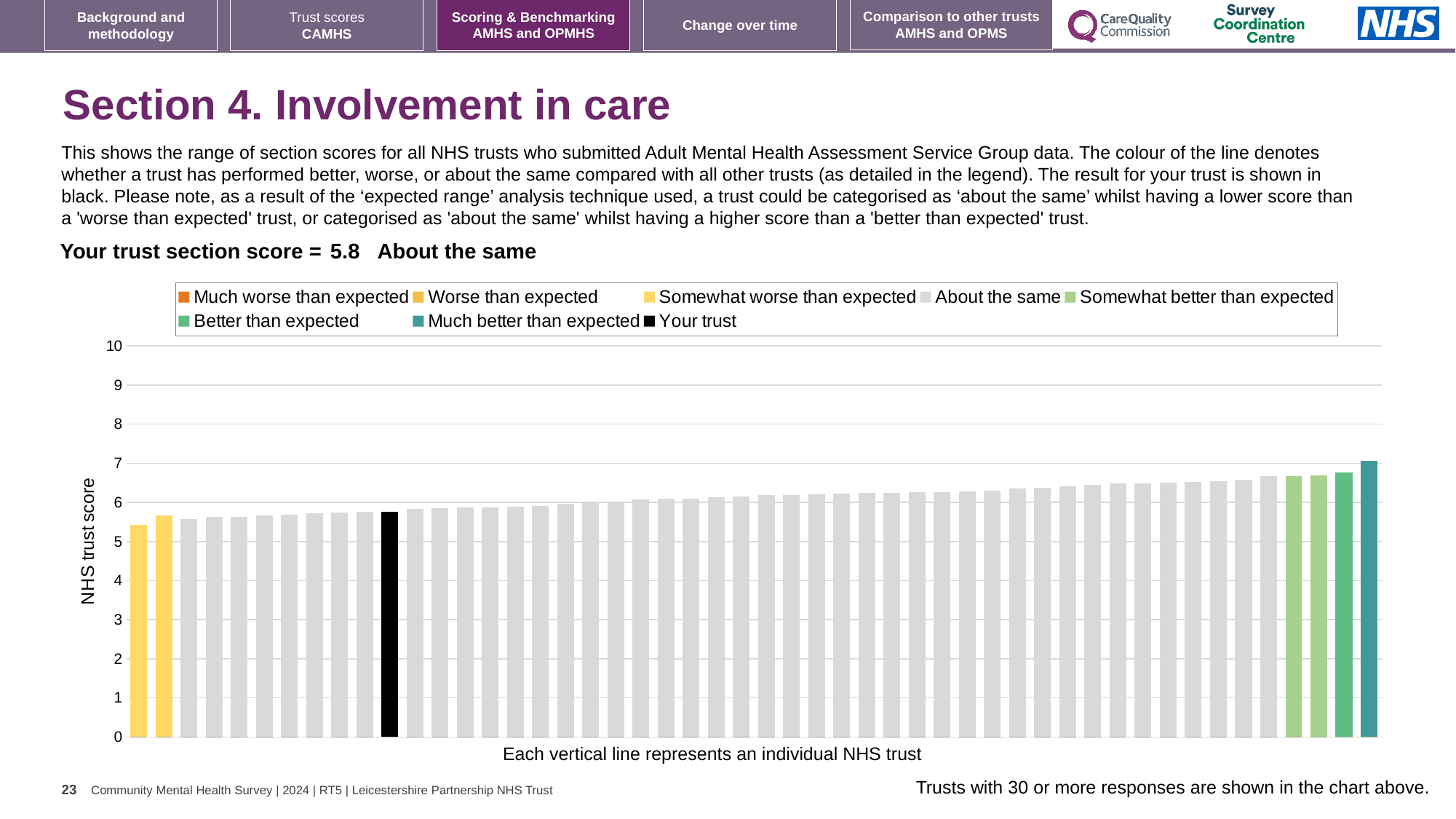
Which legend category does the tallest bar belong to? Much better than expected What kind of chart is shown on the slide? Bar chart Which legend category does the shortest bar belong to? Somewhat worse than expected Is the value of the leftmost bar greater or less than 6? less Do the bar values rise or fall from left to right along the x axis? Rise Is the value of the tallest bar (the rightmost, teal bar) greater or less than 6? greater Which category is your trust placed in for this section? About the same Is the value of the black 'Your trust' bar greater or less than 6? less How many entries does the chart legend list? 8 What is the section score for your trust shown on the slide? 5.8 What is the label on the vertical axis of the chart? NHS trust score